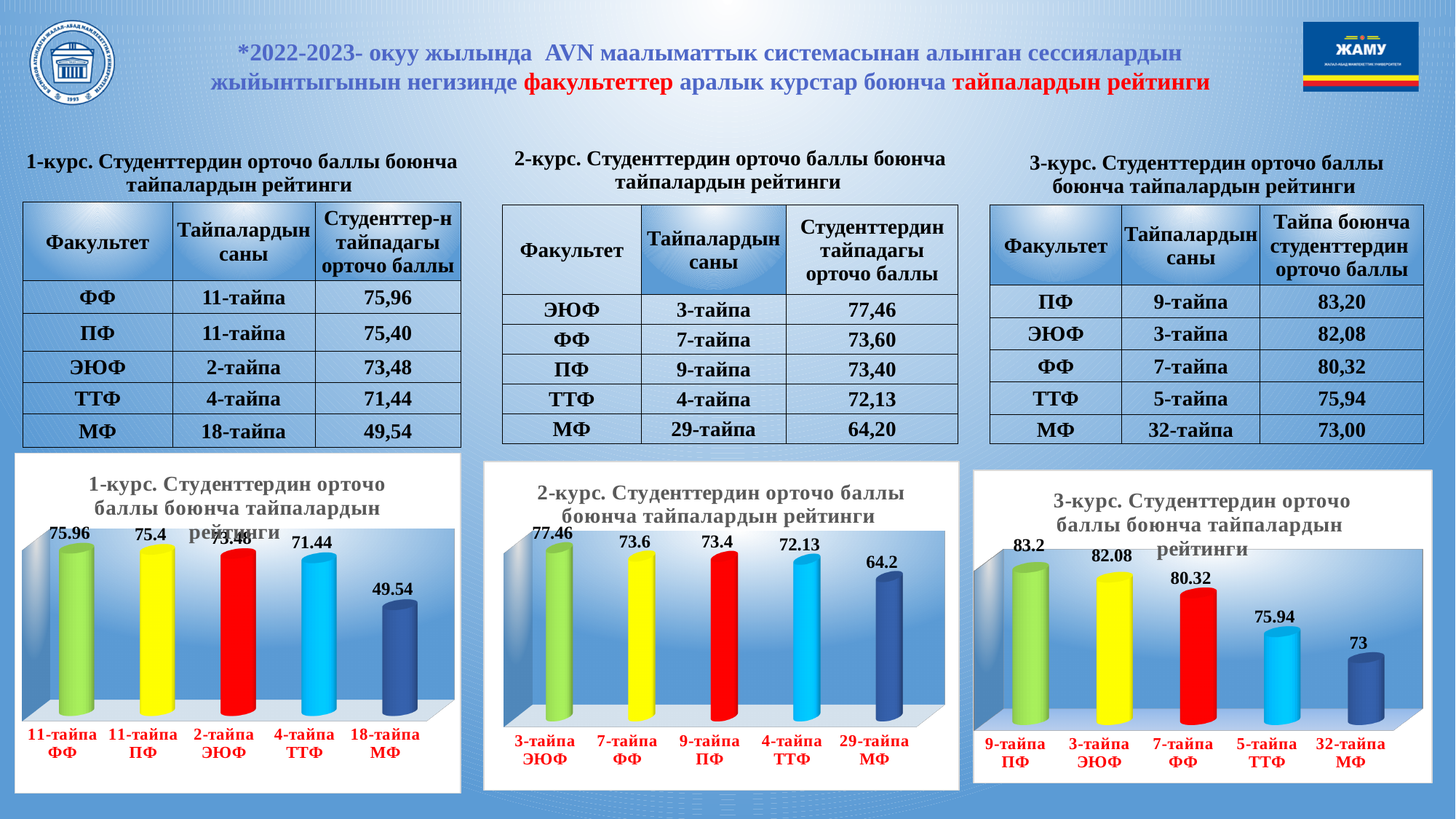
In the 2-курс chart (middle), what is the value for ТТФ? 72.13 In the 2-курс chart (middle), which faculty has the highest value? ЭЮФ In the 1-курс chart (left), which faculty has the lowest value? МФ What kind of chart is the 3-курс chart (right)? bar chart In the 2-курс chart (middle), how many bars are plotted? 5 In the 2-курс chart (middle), what is the difference between the values for ЭЮФ and МФ? 13.26 In the 1-курс chart (left), what is the difference between the values for ФФ and МФ? 26.42 In the 3-курс chart (right), what is the value for ПФ? 83.2 In the 3-курс chart (right), which is larger, the value for ФФ or the value for ТТФ? ФФ In the 1-курс chart (left), what colour is the bar for ЭЮФ? red In the 1-курс chart (left), what is the value for ФФ? 75.96 In the 3-курс chart (right), do the values rise or fall from left to right? fall